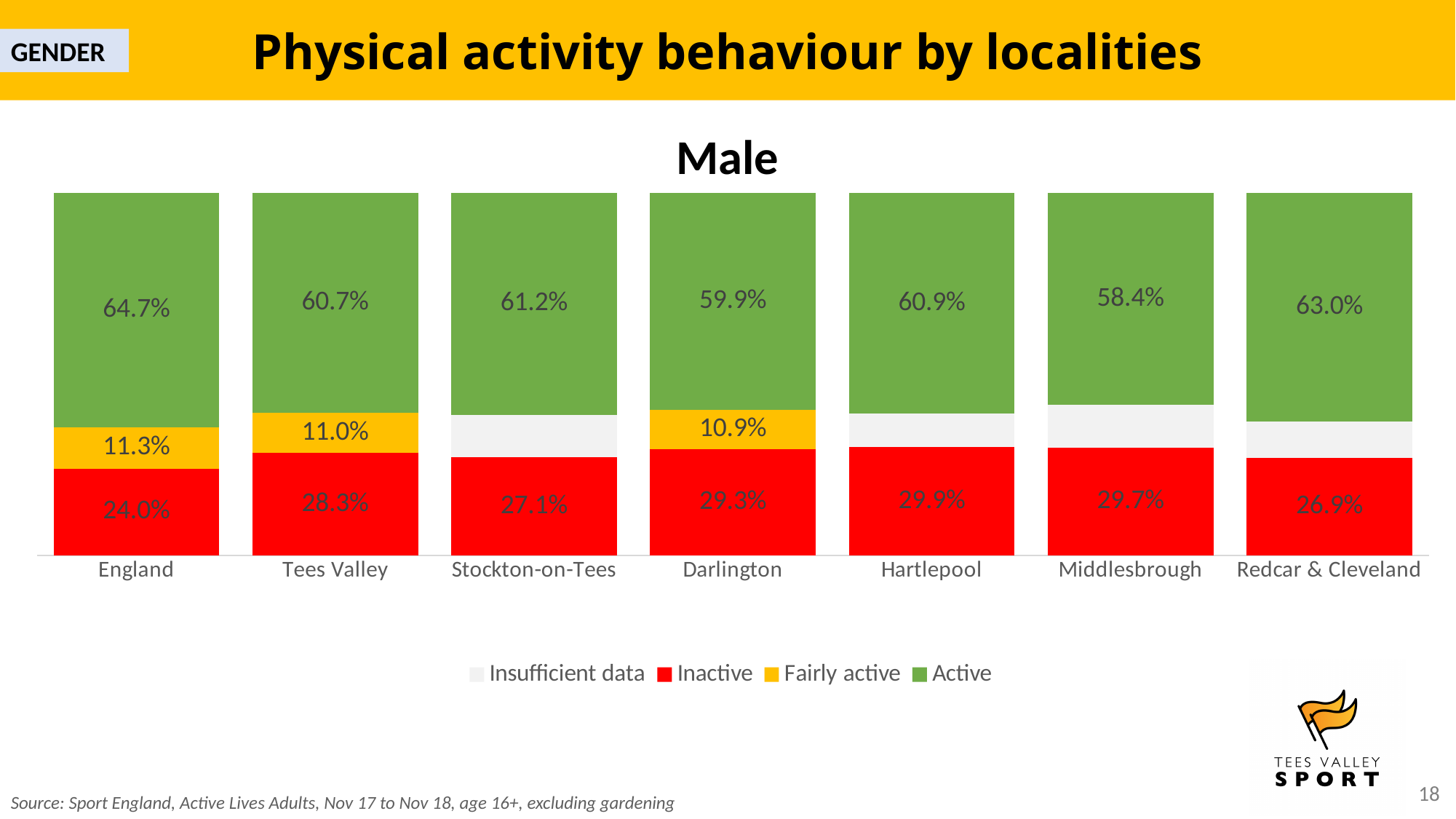
Which locality has the lowest Inactive percentage for males? England Which has a higher Inactive percentage for males, Tees Valley or Stockton-on-Tees? Tees Valley What is the Fairly active percentage for males in Tees Valley? 11.0% What is the Inactive percentage for males in Darlington? 29.3% What kind of chart is shown on the slide? Stacked bar chart How many localities are shown on the chart? 7 Which locality has the lowest Active percentage for males? Middlesbrough What percentage of males in England are Active? 64.7% What is the difference in the Active percentage between England and Middlesbrough? 6.3 percentage points How many series does the legend list? 4 Which locality has the highest Active percentage for males? England What is the total of the England stacked bar (Active, Fairly active and Inactive)? 100.0%